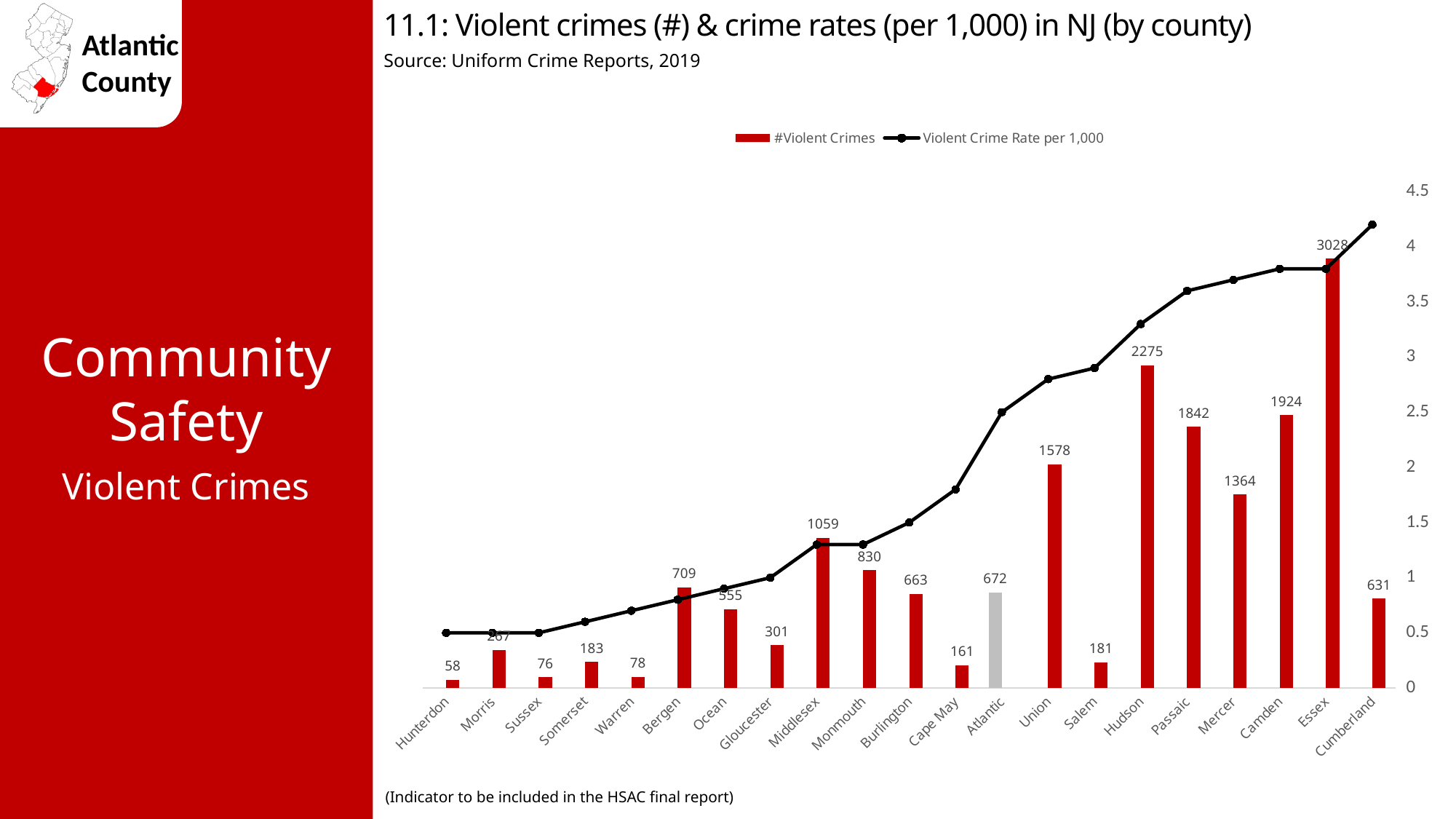
Does the violent crime rate line generally rise or fall from Hunterdon to Cumberland? rise Is the violent crime rate per 1,000 for Union greater or less than 2.5? greater Which county has the highest number of violent crimes? Essex Which county has more violent crimes, Camden or Passaic? Camden How many series does the legend list? 2 How many counties are shown on the x axis? 21 What is the difference in the number of violent crimes between Hudson and Passaic? 433 Is the violent crime rate per 1,000 for Cumberland greater or less than 4? greater What is the number of violent crimes for Atlantic county? 672 How many violent crimes are shown for Essex county? 3028 Which county has the lowest number of violent crimes? Hunterdon What kind of chart is this? Combined bar and line chart